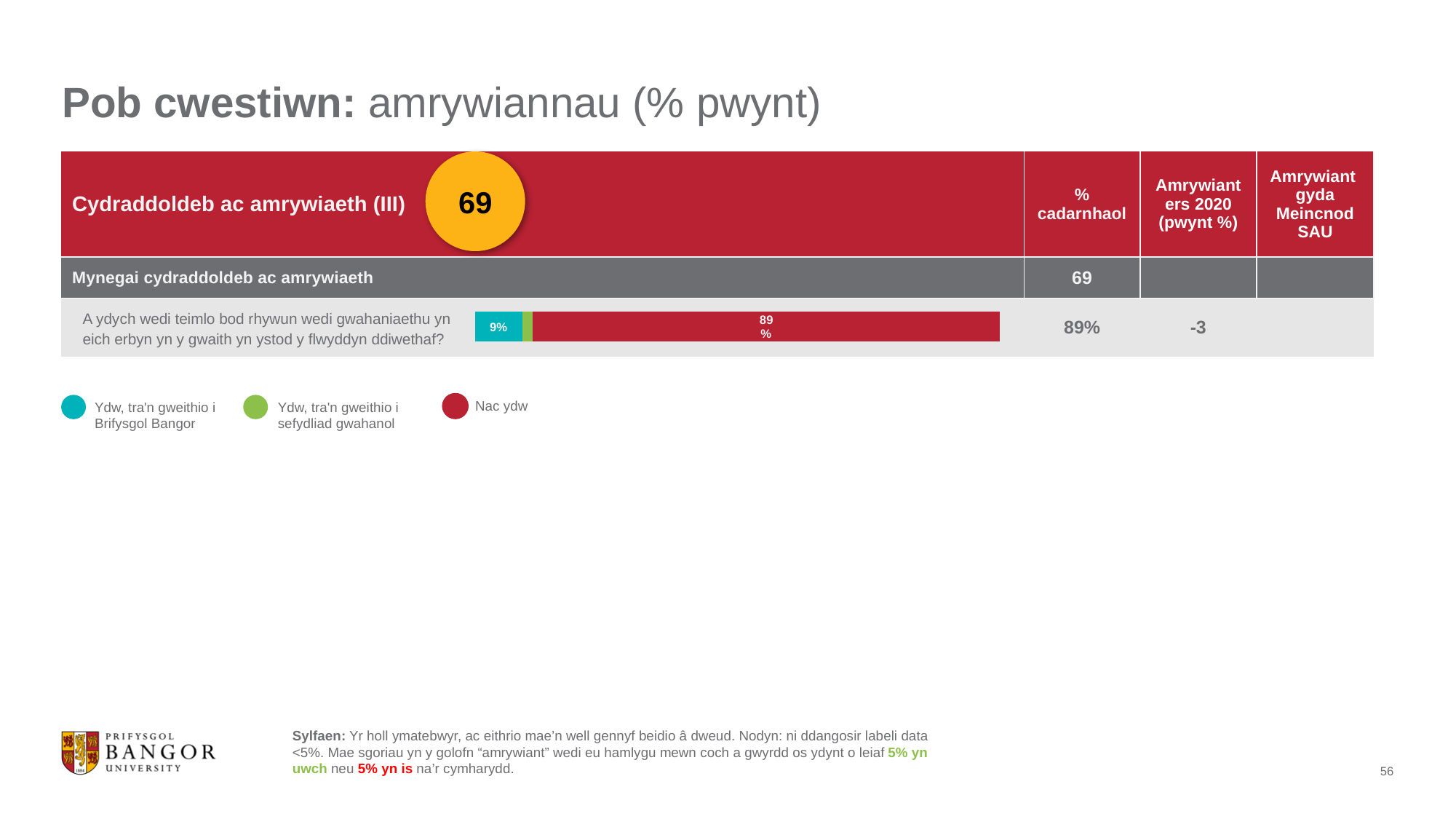
What percentage of respondents answered "Ydw, tra'n gweithio i Brifysgol Bangor"? 9% Which is larger: the share for "Nac ydw" or the share for "Ydw, tra'n gweithio i Brifysgol Bangor"? Nac ydw How many response categories does the legend list? 3 What is the "Amrywiant ers 2020 (pwynt %)" value shown for the question about discrimination at work? -3 Which response category has the largest share of the bar? Nac ydw What score is shown in the orange circle for "Cydraddoldeb ac amrywiaeth (III)"? 69 What percentage of respondents answered "Nac ydw" to the question about feeling discriminated against at work in the last year? 89% How many question rows with a bar are shown on the slide? 1 What is the "% cadarnhaol" value shown for the question about discrimination at work? 89% Which colour represents "Nac ydw" in the legend? Red What is the difference in percentage points between the "Nac ydw" share and the "Ydw, tra'n gweithio i Brifysgol Bangor" share? 80 What kind of chart is used to show the responses? Stacked bar chart